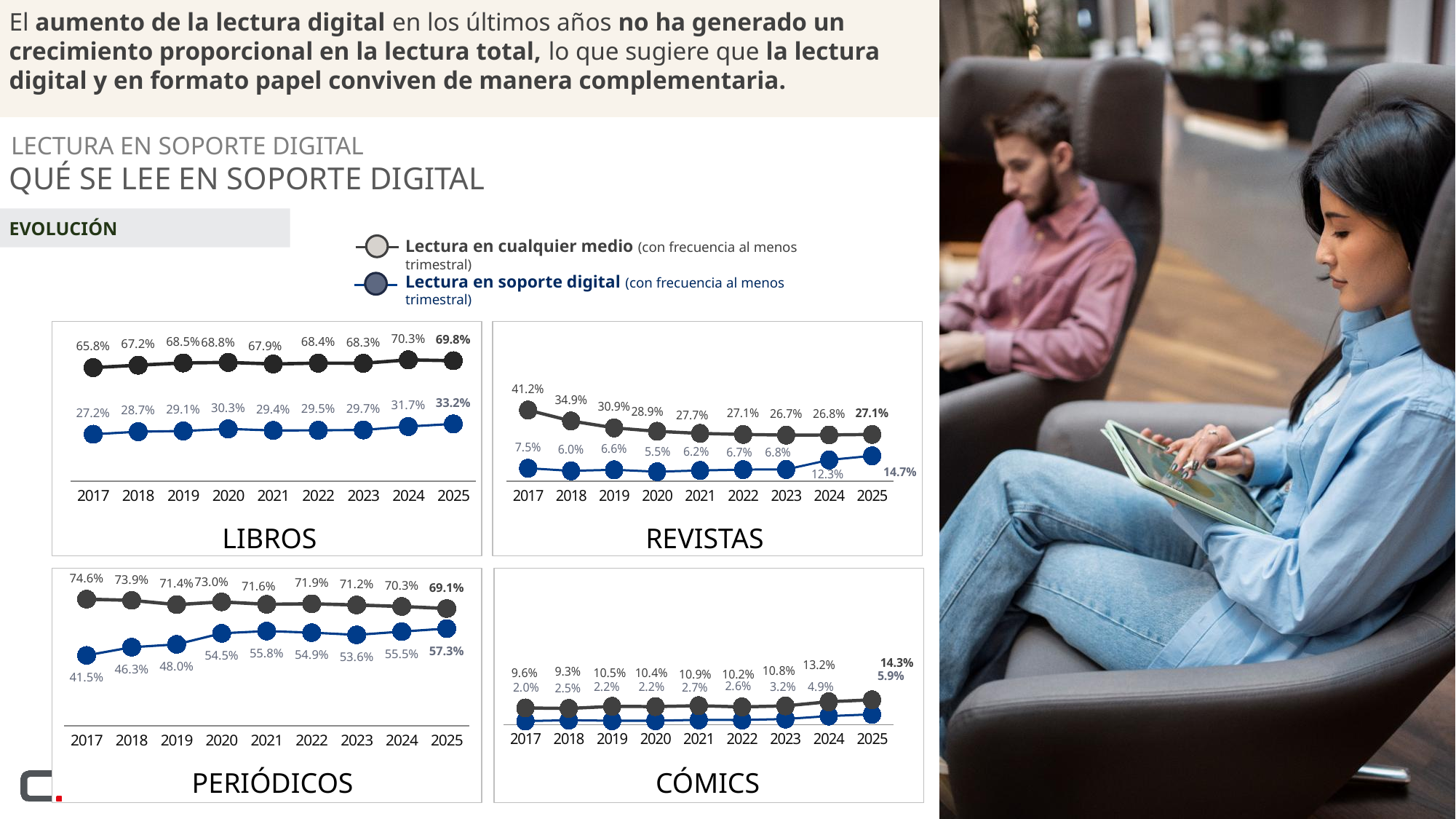
How many series does the legend list for the charts? 2 In the LIBROS chart, what is the value for 'Lectura en soporte digital' in 2025? 33.2% In the PERIÓDICOS chart, which year has the highest value for 'Lectura en cualquier medio'? 2017 In the REVISTAS chart, which year has the lowest value for 'Lectura en soporte digital'? 2020 In the REVISTAS chart, does 'Lectura en cualquier medio' rise or fall from 2017 to 2025? Fall Which is larger in 2024: 'Lectura en soporte digital' in the LIBROS chart or in the REVISTAS chart? LIBROS How many years are plotted on the x axis of the LIBROS chart? 9 In the PERIÓDICOS chart, what is the difference between 'Lectura en cualquier medio' and 'Lectura en soporte digital' in 2025? 11.8 percentage points In the PERIÓDICOS chart, does 'Lectura en soporte digital' rise or fall from 2017 to 2025? Rise What kind of chart is the CÓMICS chart? Line chart In the REVISTAS chart, what is the value for 'Lectura en cualquier medio' in 2017? 41.2% In the CÓMICS chart, which year has the highest value for 'Lectura en soporte digital'? 2025